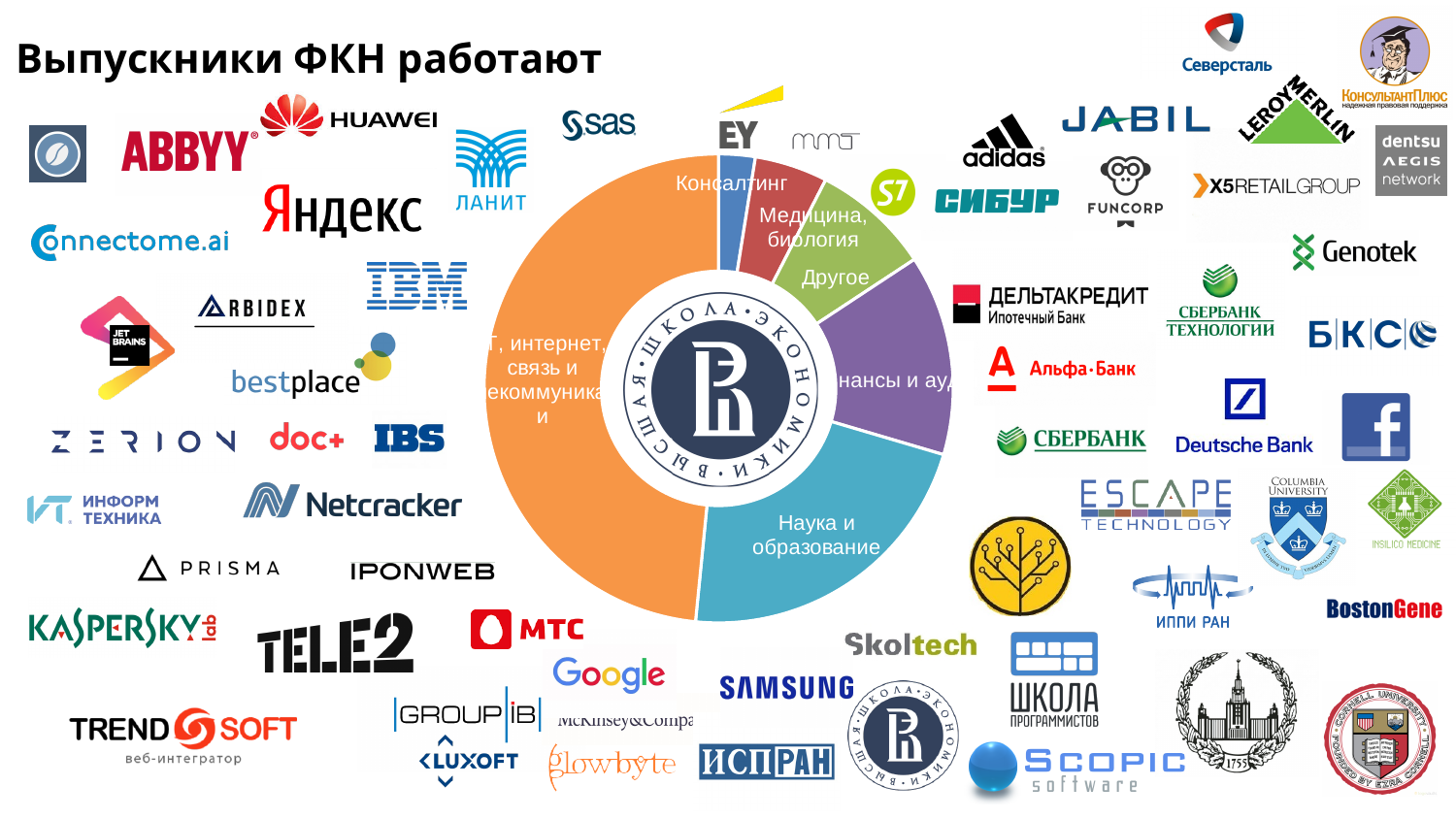
Which category has the smallest slice in the donut chart? Консалтинг What is the title of the slide containing the chart? Выпускники ФКН работают Which category is the second largest slice in the donut chart? Наука и образование What colour is the Наука и образование slice in the donut chart? Light blue (cyan) Which category has the largest slice in the donut chart? IT, интернет, связь и телекоммуникации Which slice is larger: Консалтинг or Другое? Другое Which slice is larger: Медицина, биология or Консалтинг? Медицина, биология Which slice is larger: Наука и образование or Финансы и аудит? Наука и образование How many categories (slices) does the donut chart have? 6 What kind of chart is shown on the slide? Donut (pie) chart